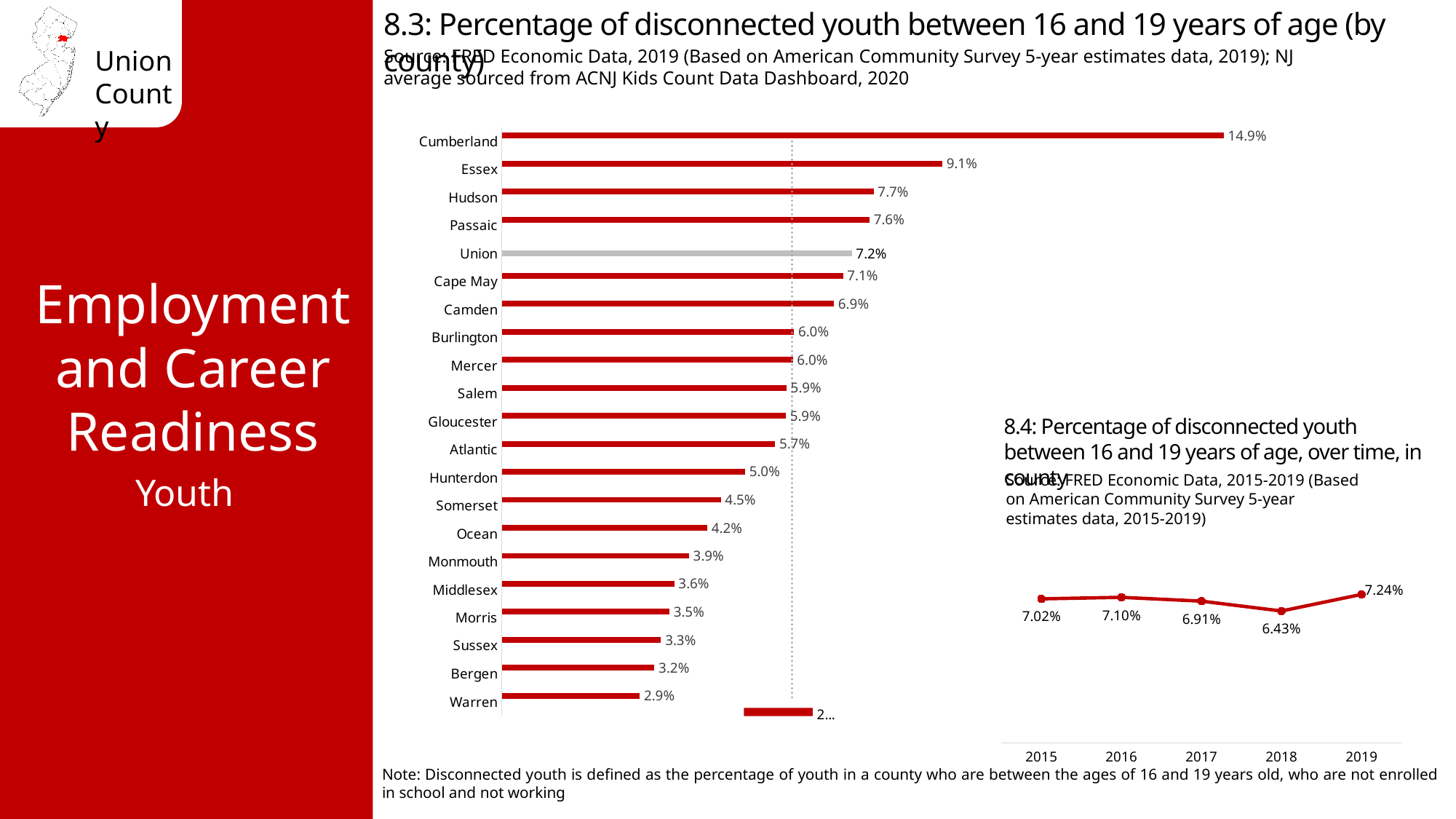
In chart 8.4 (percentage of disconnected youth over time), what is the value for 2018? 6.43% In chart 8.4 (percentage of disconnected youth over time), which year has the highest value? 2019 In chart 8.3 (percentage of disconnected youth by county), how many counties are plotted? 21 In chart 8.3 (percentage of disconnected youth by county), what is the value for Bergen? 3.2% What kind of chart is chart 8.3 (percentage of disconnected youth by county)? Bar chart In chart 8.3 (percentage of disconnected youth by county), which is larger, Hudson or Passaic? Hudson In chart 8.3 (percentage of disconnected youth by county), what is the difference between Cumberland and Essex? 5.8% What kind of chart is chart 8.4 (percentage of disconnected youth over time)? Line chart In chart 8.3 (percentage of disconnected youth by county), which county has the highest value? Cumberland In chart 8.3 (percentage of disconnected youth by county), what is the value for Union? 7.2% In chart 8.4 (percentage of disconnected youth over time), what is the difference between 2019 and 2018? 0.81% In chart 8.3 (percentage of disconnected youth by county), which county has the lowest value? Warren